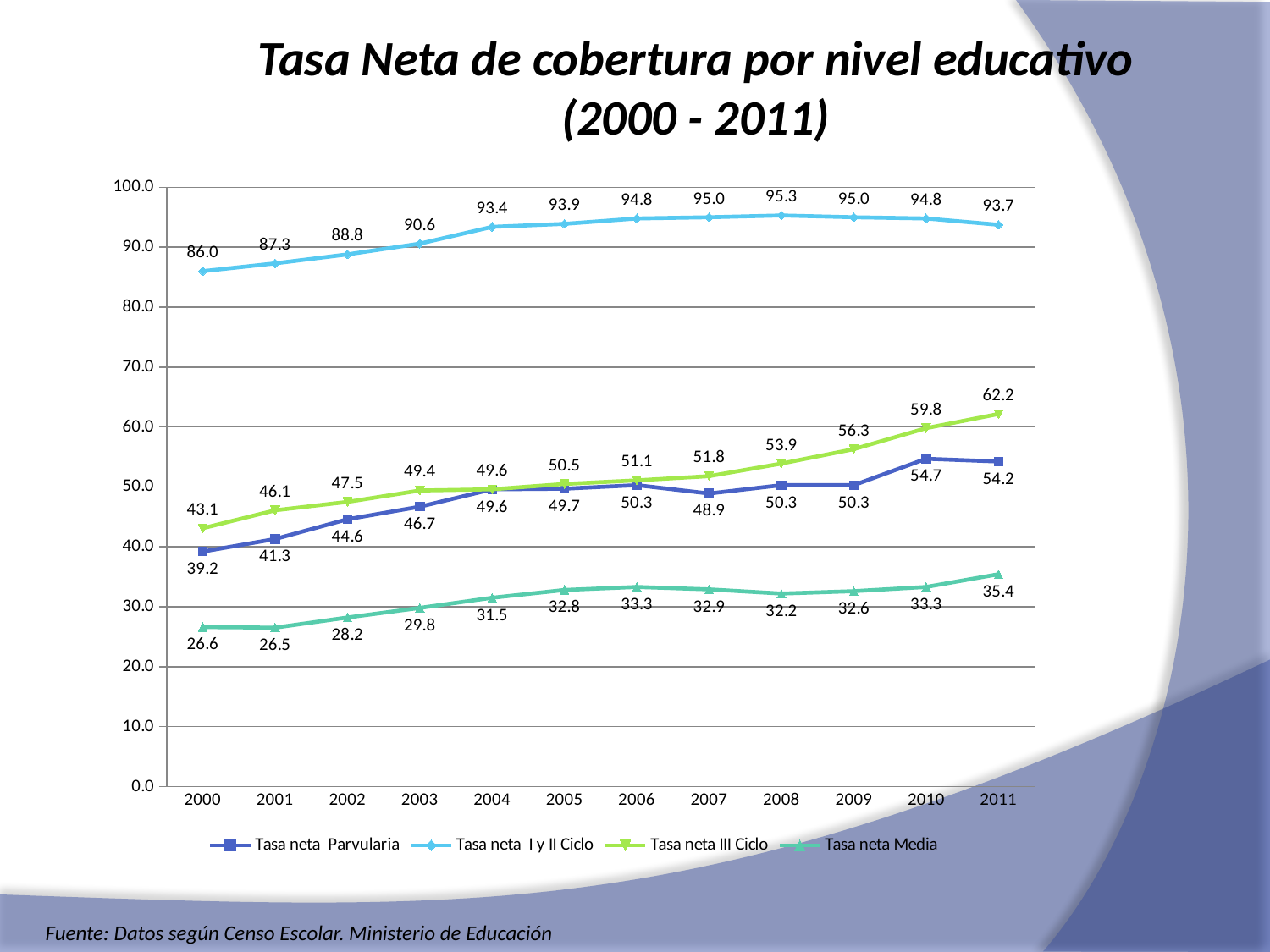
How many series does the legend list? 4 In which year does Tasa neta III Ciclo reach its highest value? 2011 What is the value of Tasa neta I y II Ciclo in 2008? 95.3 What kind of chart is shown on the slide? Line chart In 2011, which is larger: Tasa neta Parvularia or Tasa neta III Ciclo? Tasa neta III Ciclo What is the title of the chart? Tasa Neta de cobertura por nivel educativo (2000 - 2011) In which year is Tasa neta I y II Ciclo at its lowest? 2000 How many years are plotted on the x axis? 12 What is the value of Tasa neta Parvularia in 2007? 48.9 Does Tasa neta III Ciclo rise or fall from 2000 to 2011? Rise What is the value of Tasa neta Media in 2011? 35.4 By how much did Tasa neta III Ciclo increase from 2000 to 2011? 19.1